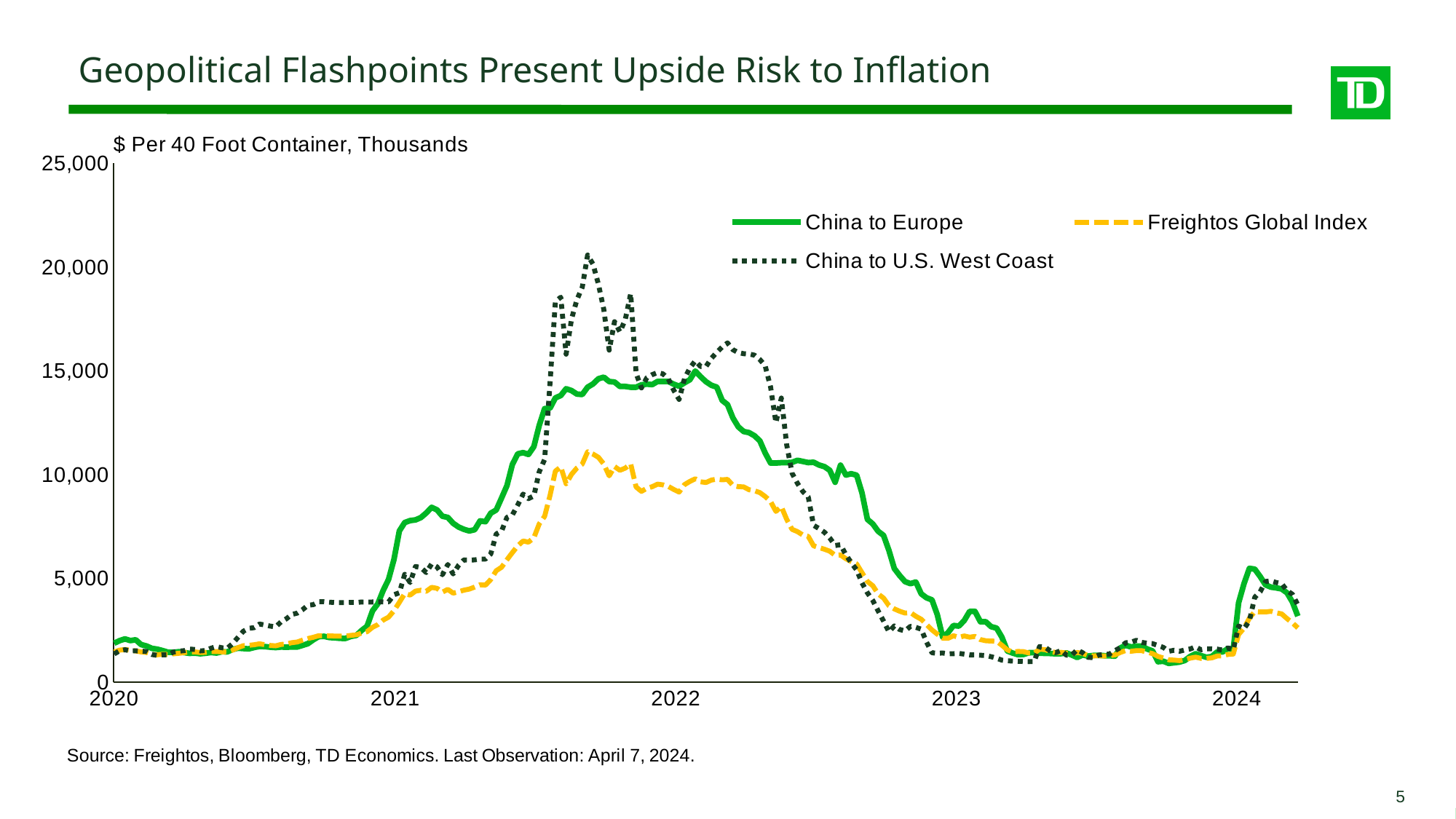
Is the peak value for China to U.S. West Coast greater or less than 20,000? greater Which is larger at the peak in late 2021: China to U.S. West Coast or Freightos Global Index? China to U.S. West Coast What unit label is shown above the y axis? $ Per 40 Foot Container, Thousands How many series does the legend list? 3 Which series stays lowest during the 2021-2022 peak period? Freightos Global Index Do the series rise or fall between the start of 2022 and the start of 2023? fall Is the peak value for the Freightos Global Index greater or less than 10,000? greater What is the title of the slide? Geopolitical Flashpoints Present Upside Risk to Inflation Which series reaches the highest peak on the chart? China to U.S. West Coast What kind of chart is shown on the slide? line chart At the start of 2020, are all three series greater or less than 5,000? less